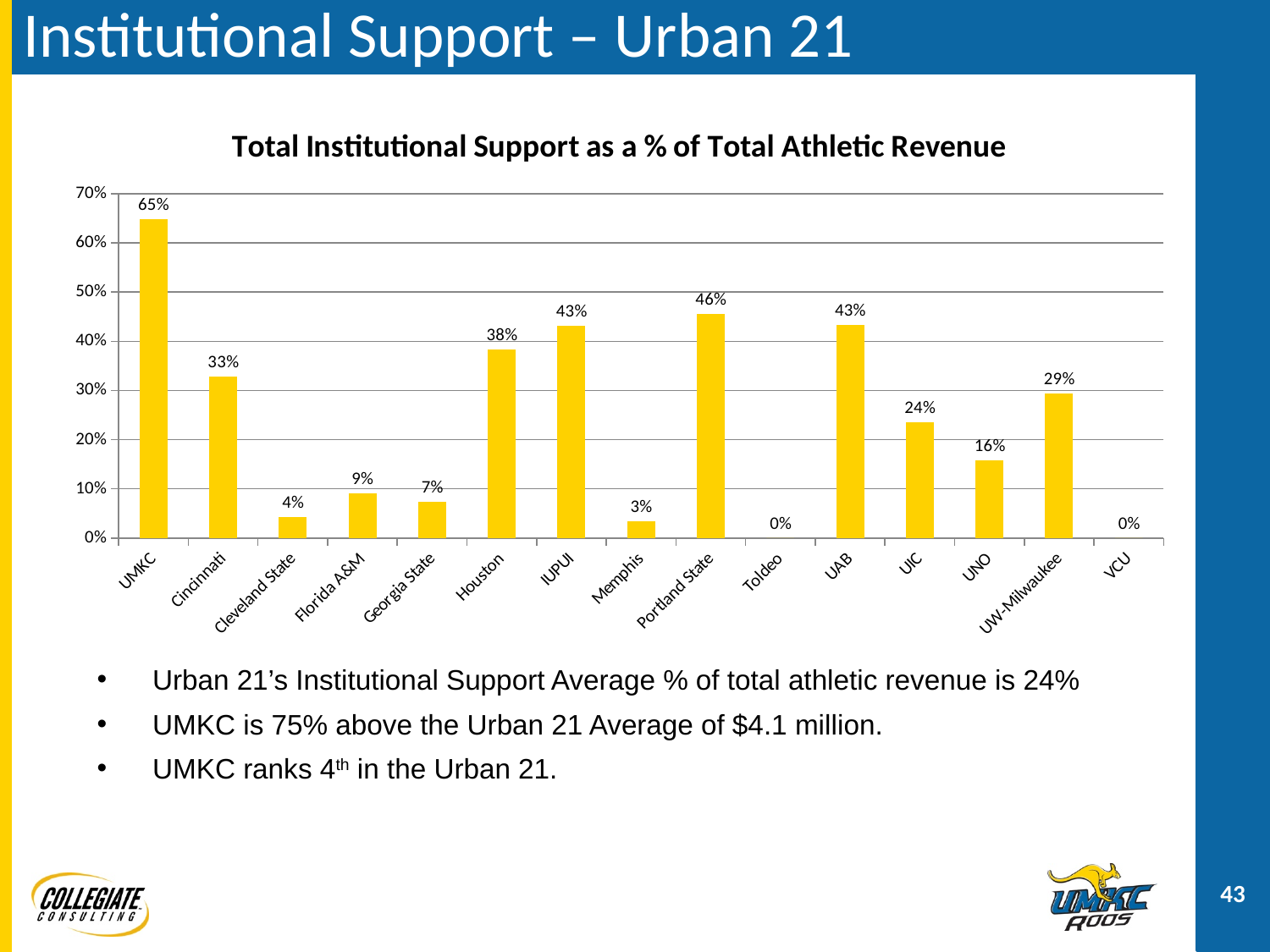
What is the difference between the values for Houston and Memphis? 35 percentage points Which is larger, the value for Portland State or the value for IUPUI? Portland State What kind of chart is shown? Bar chart What is the value for UMKC? 65% What is the title of the chart? Total Institutional Support as a % of Total Athletic Revenue What is the value for UW-Milwaukee? 29% What is the difference between the values for UMKC and Cincinnati? 32 percentage points How many institutions are shown on the chart? 15 What is the value for Houston? 38% Which institution has the highest value? UMKC How many institutions have a value of 0%? 2 What is the value for UIC? 24%